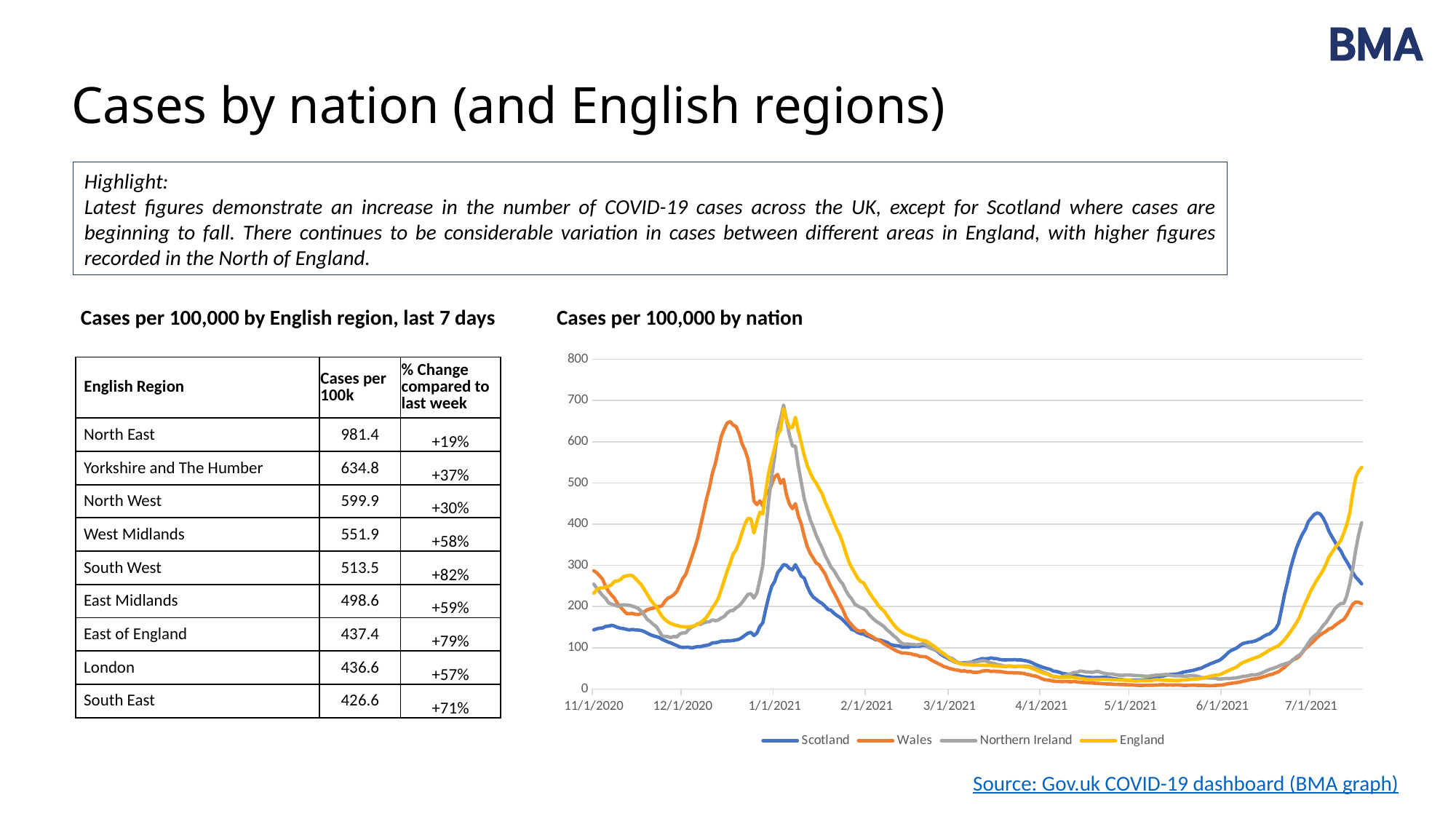
How many date labels are shown on the x axis of the 'Cases per 100,000 by nation' chart? 9 In the 'Cases per 100,000 by nation' chart, which nations are listed in the legend? Scotland, Wales, Northern Ireland, England In the 'Cases per 100,000 by nation' chart, what colour is the Scotland line? blue In the 'Cases per 100,000 by nation' chart, around 7/1/2021, is the value for Scotland or England higher? Scotland In the 'Cases per 100,000 by nation' chart, is the value for Wales at the right end of the chart greater or less than 300? less What kind of chart is 'Cases per 100,000 by nation'? line chart In the 'Cases per 100,000 by nation' chart, is the peak value for Wales in December 2020 greater or less than 600? greater In the 'Cases per 100,000 by nation' chart, is the peak value for Scotland in January 2021 greater or less than 400? less How many series does the legend of the 'Cases per 100,000 by nation' chart list? 4 In the 'Cases per 100,000 by nation' chart, which nation has the highest value at the right end of the chart? England In the 'Cases per 100,000 by nation' chart, does the Scotland line rise or fall between 7/1/2021 and the end of the chart? fall